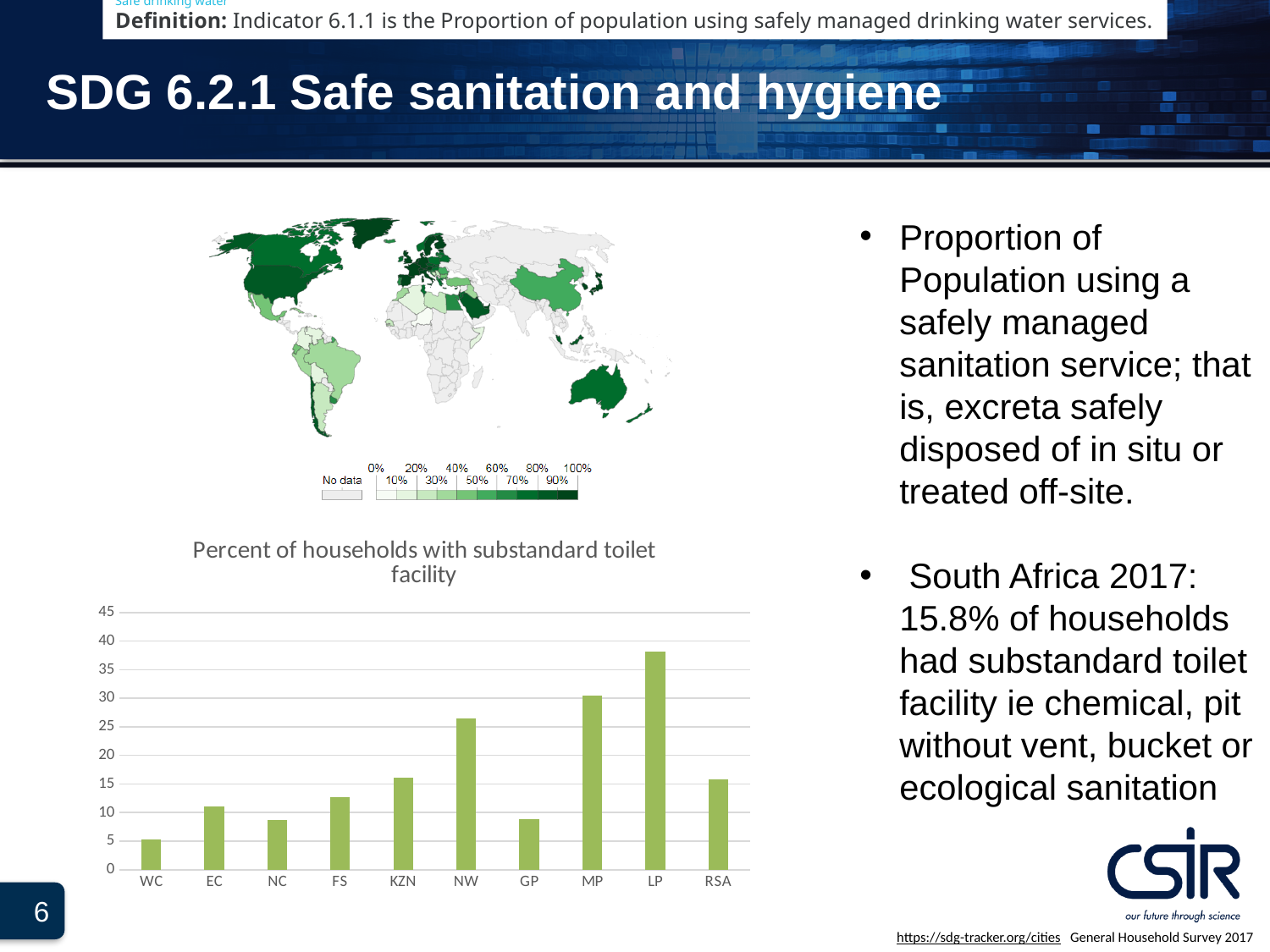
Is the value for NW greater or less than 20? greater Which category has the highest percent of households with substandard toilet facility? LP Is the value for WC greater or less than 10? less How many provinces/categories are shown on the x axis of the bar chart? 10 What is the title of the bar chart on the slide? Percent of households with substandard toilet facility Which category has the lowest percent of households with substandard toilet facility? WC Which has a higher percent of households with substandard toilet facility, MP or NW? MP Is the value for MP greater or less than 25? greater What kind of chart is 'Percent of households with substandard toilet facility'? bar chart Which has a higher percent of households with substandard toilet facility, KZN or GP? KZN